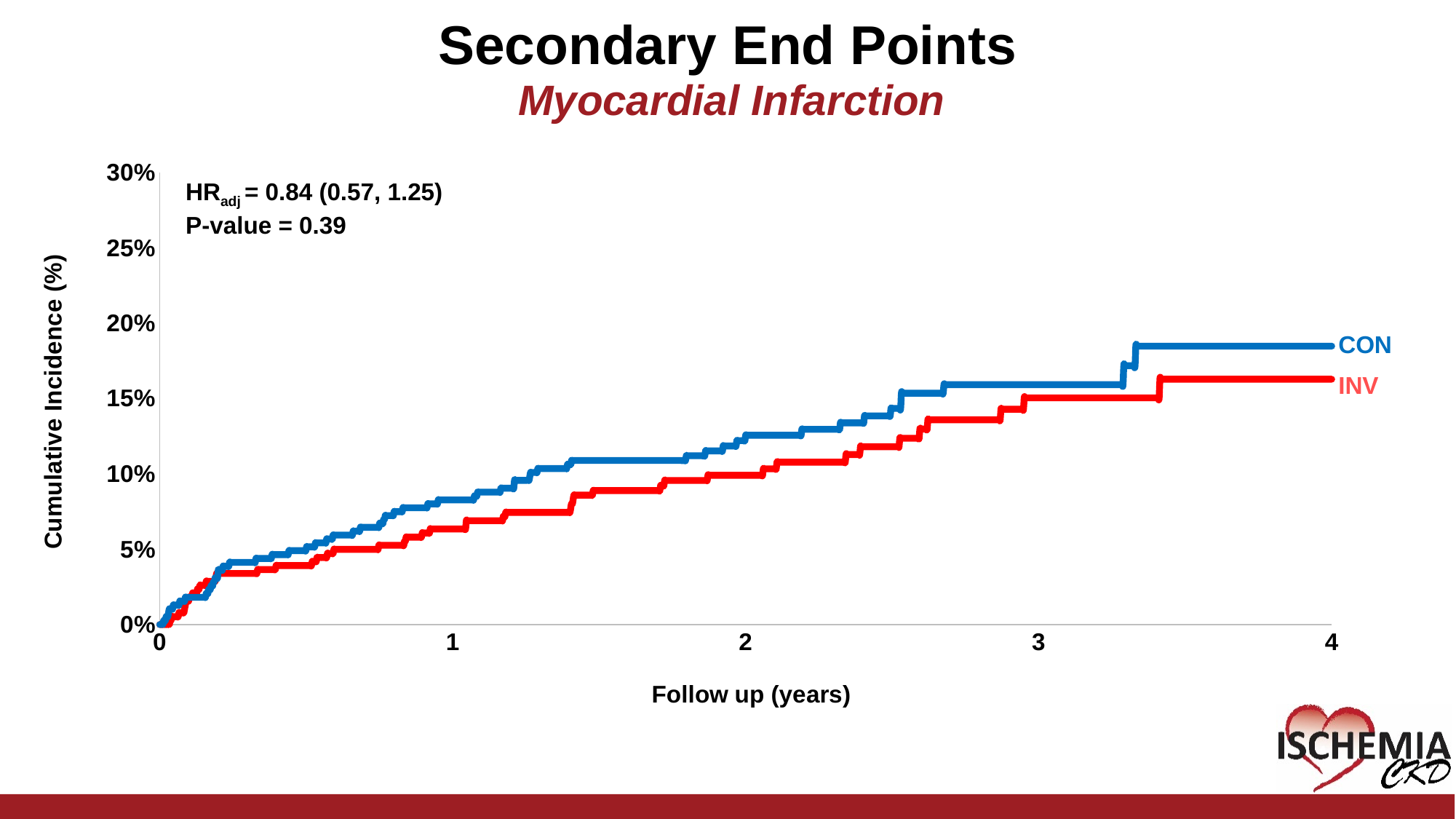
What kind of chart is shown on the slide? line chart At 4 years of follow up, which group has the higher cumulative incidence, CON or INV? CON Do the cumulative incidence curves rise or fall as follow-up time increases? rise Is the cumulative incidence for CON at 4 years greater or less than 15%? greater What is the label of the x axis? Follow up (years) Is the cumulative incidence for INV at 1 year greater or less than 10%? less Is the cumulative incidence for CON at 2 years greater or less than 10%? greater What adjusted hazard ratio is printed on the chart? 0.84 (0.57, 1.25) Which two groups are plotted on the chart? CON and INV At 2 years of follow up, which group has the higher cumulative incidence, CON or INV? CON How many series are plotted on the chart? 2